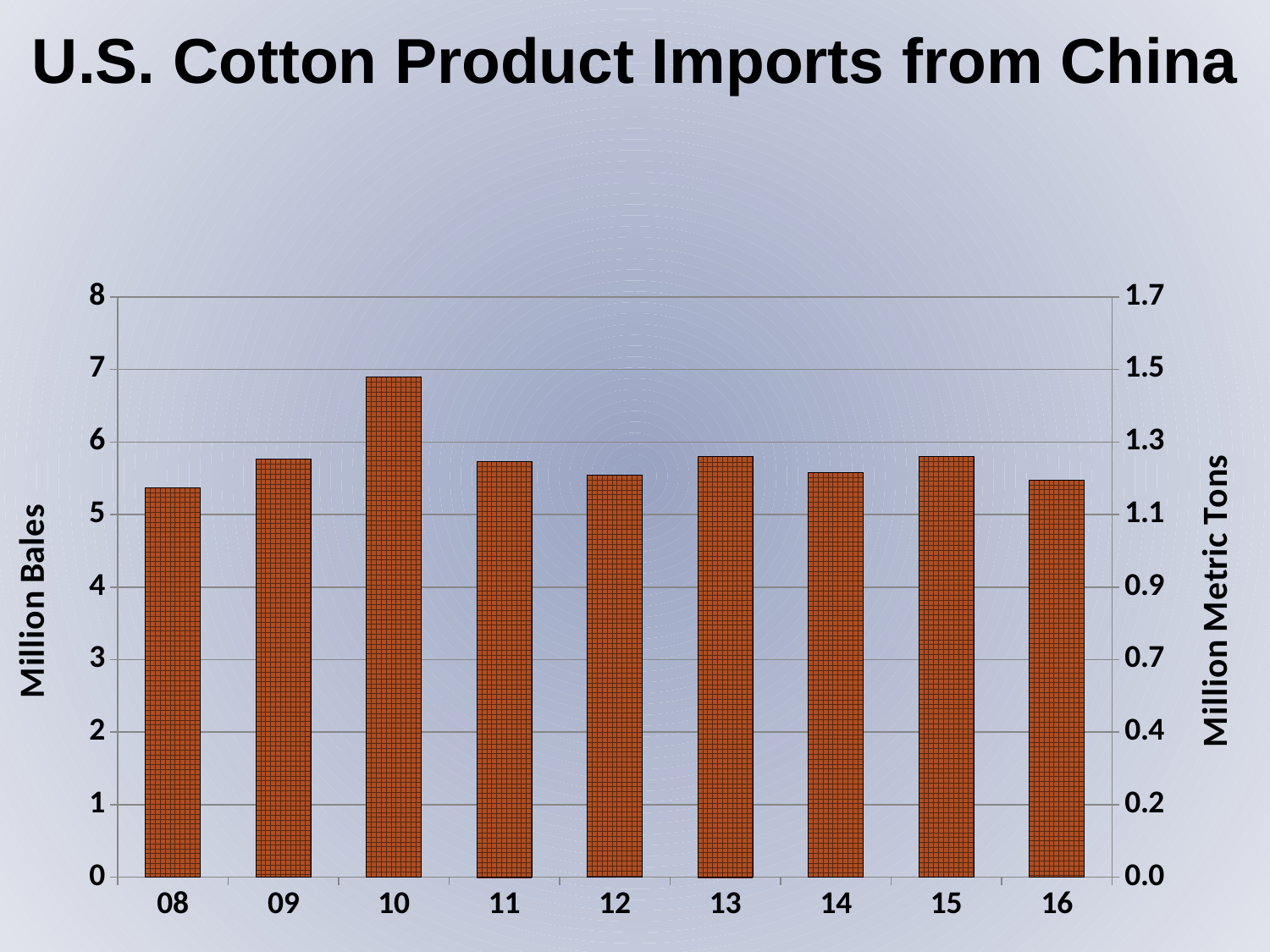
Is the value for 08 greater or less than 6 million bales? less What is the title of the chart? U.S. Cotton Product Imports from China Is the value for 16 greater or less than 5 million bales? greater How many years (bars) are plotted on the chart? 9 Which is larger, the value for 10 or the value for 11? 10 Do the values rise or fall from 08 to 10? rise Is the value for 10 greater or less than 6 million bales? greater Which year has the highest U.S. cotton product imports from China? 10 What is the label on the right-hand vertical axis? Million Metric Tons Which is larger, the value for 08 or the value for 09? 09 What kind of chart is shown on the slide? bar chart